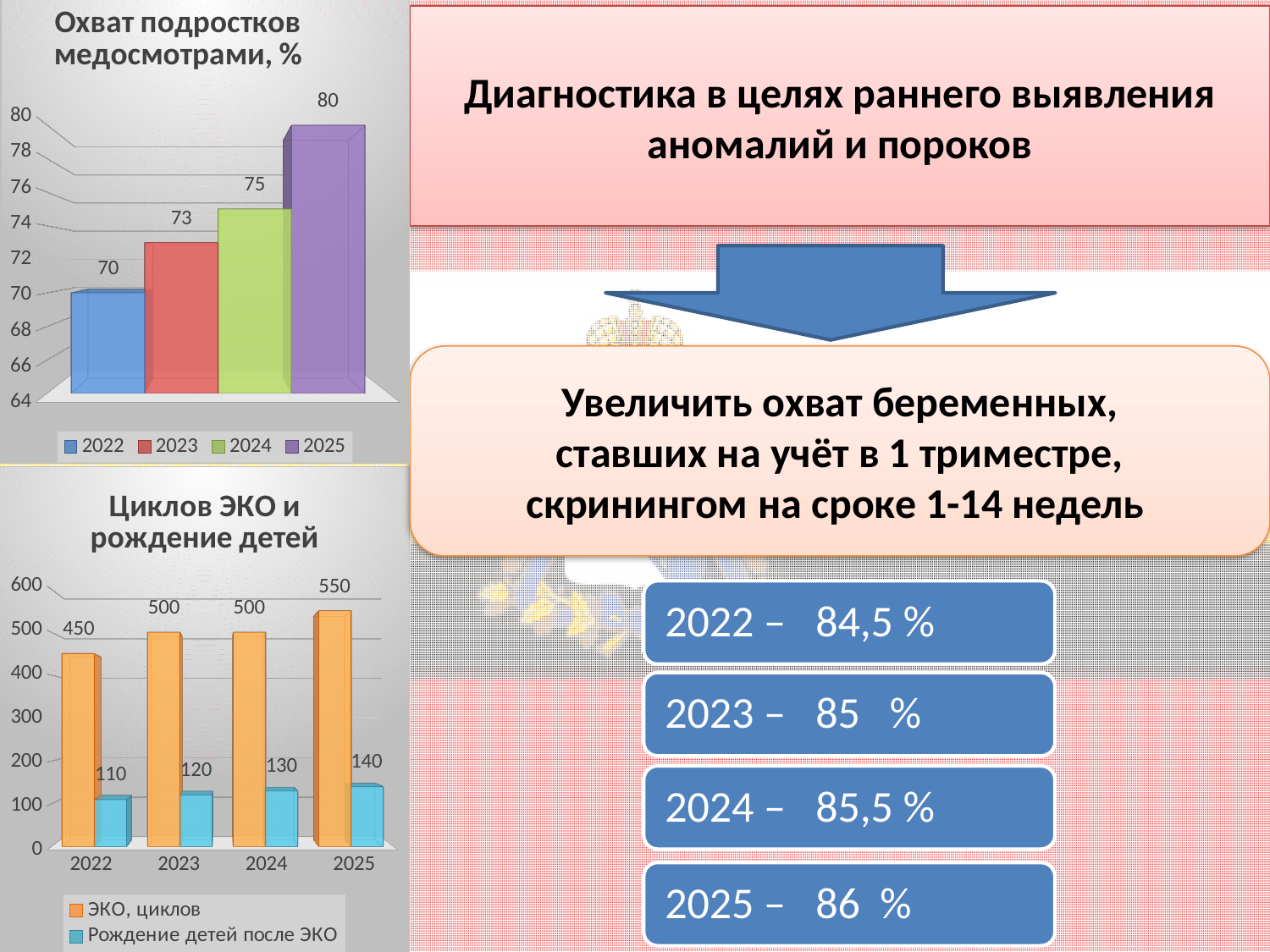
In the chart 'Охват подростков медосмотрами, %', what is the difference between the values for 2025 and 2022? 10 How many entries does the legend of the chart 'Охват подростков медосмотрами, %' list? 4 In the chart 'Охват подростков медосмотрами, %', which year has the lowest value? 2022 In the chart 'Циклов ЭКО и рождение детей', how many years are shown on the x axis? 4 In the chart 'Циклов ЭКО и рождение детей', what is the value of 'ЭКО, циклов' for 2025? 550 In the chart 'Циклов ЭКО и рождение детей', what is the value of 'Рождение детей после ЭКО' for 2023? 120 In the chart 'Циклов ЭКО и рождение детей', which year has the highest value of 'Рождение детей после ЭКО'? 2025 What kind of chart is 'Циклов ЭКО и рождение детей'? bar chart In the chart 'Циклов ЭКО и рождение детей', what is the difference between 'ЭКО, циклов' and 'Рождение детей после ЭКО' in 2022? 340 In the chart 'Охват подростков медосмотрами, %', do the values rise or fall from 2022 to 2025? rise In the chart 'Охват подростков медосмотрами, %', what is the value for 2025? 80 In the chart 'Циклов ЭКО и рождение детей', which series is shown in orange? ЭКО, циклов